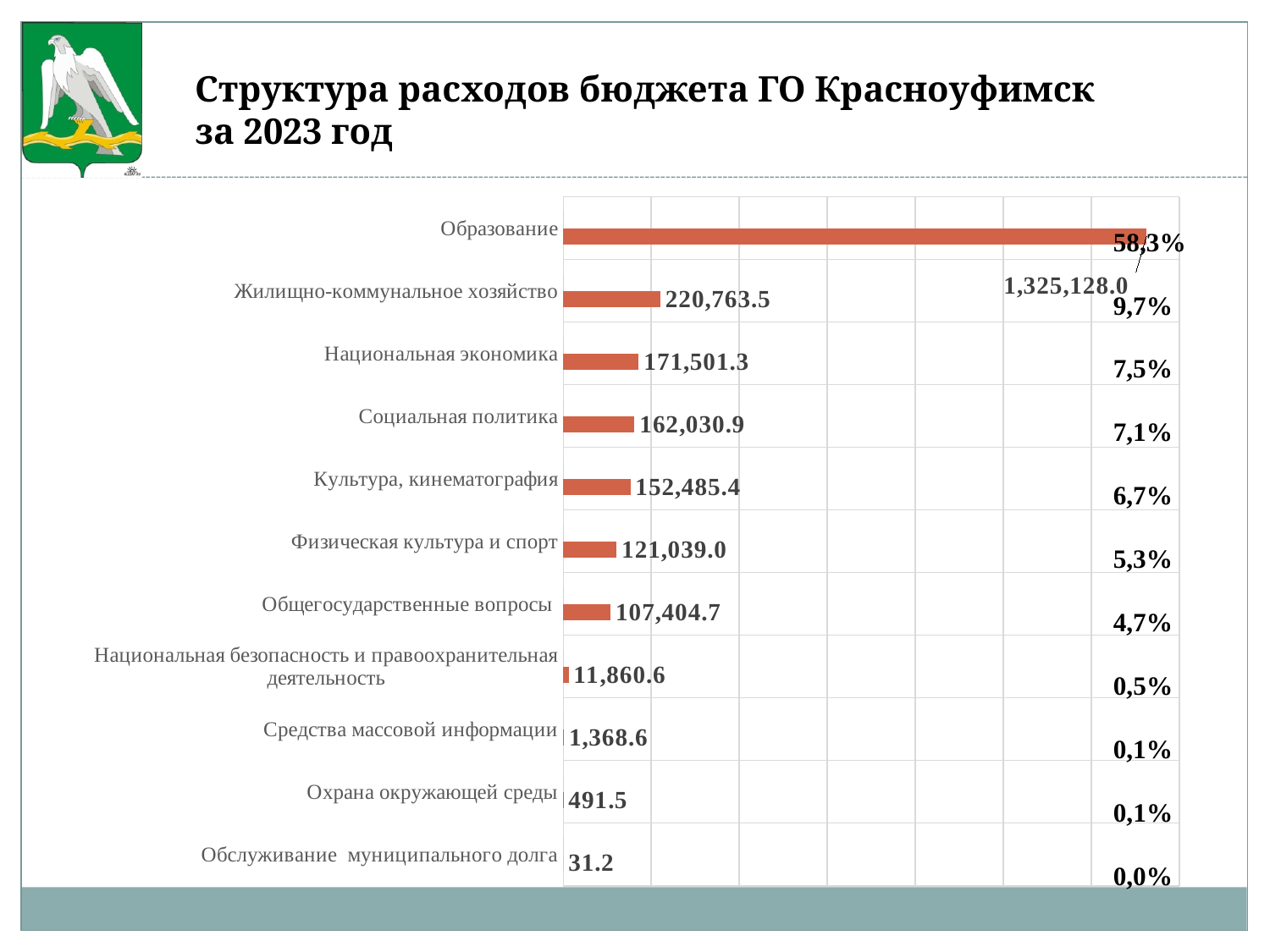
How many categories are shown in the chart? 11 What is the value for Физическая культура и спорт? 121,039.0 What type of chart is shown on the slide? Bar chart Which category has the lowest value? Обслуживание муниципального долга What is the value for Жилищно-коммунальное хозяйство? 220,763.5 What is the difference between the values for Жилищно-коммунальное хозяйство and Национальная экономика? 49,262.2 Which category has the highest value? Образование Which is larger, the value for Общегосударственные вопросы or the value for Национальная безопасность и правоохранительная деятельность? Общегосударственные вопросы What percentage share is shown next to Образование? 58,3% What is the difference between the values for Социальная политика and Культура, кинематография? 9,545.5 What is the value for Охрана окружающей среды? 491.5 What is the value for Образование? 1,325,128.0